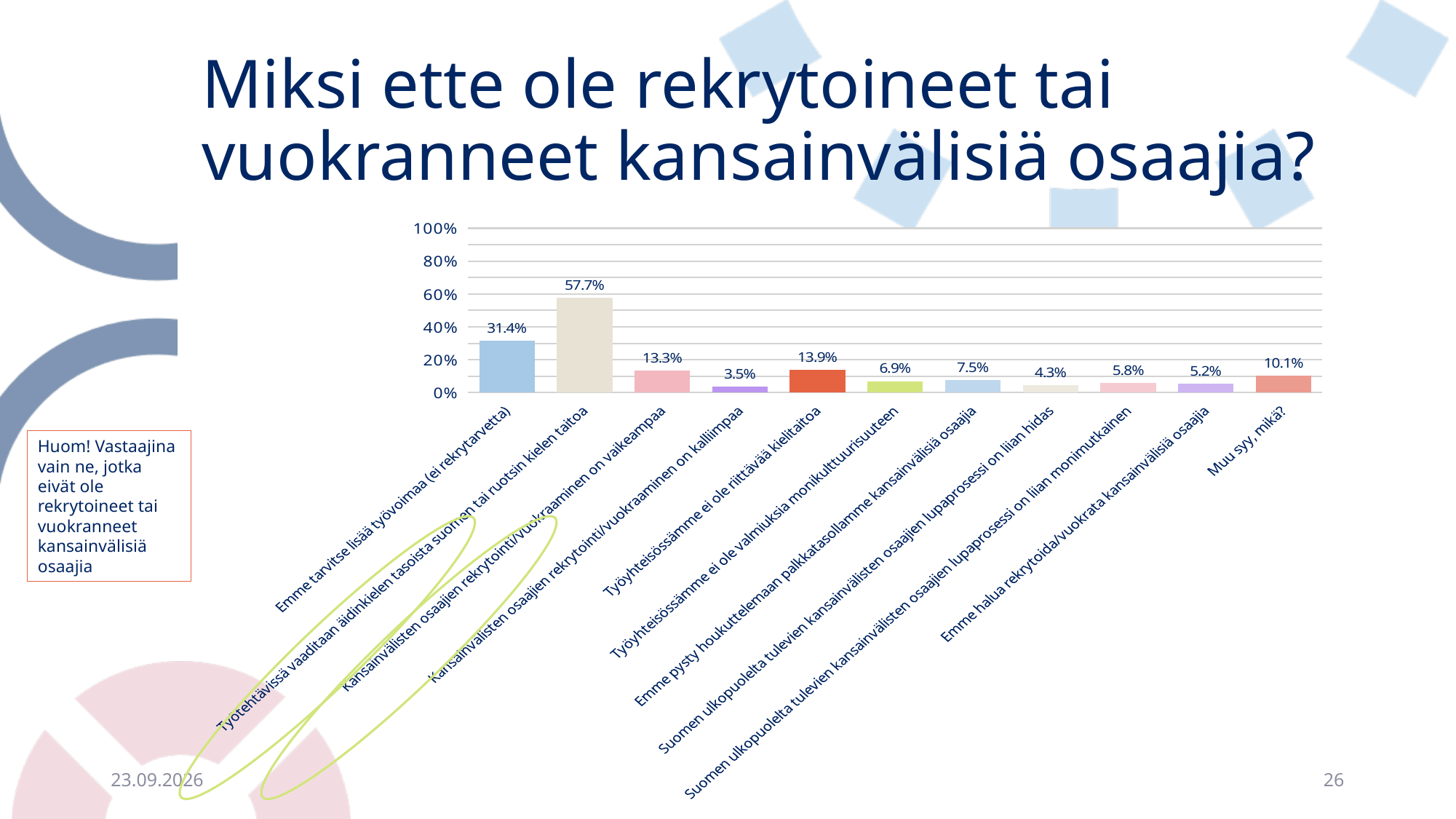
What kind of chart is shown on the slide? bar chart Is the value for "Emme tarvitse lisää työvoimaa (ei rekrytarvetta)" greater or less than 40%? less What is the value for "Muu syy, mikä?"? 10.1% Which is larger: the value for "Suomen ulkopuolelta tulevien kansainvälisten osaajien lupaprosessi on liian hidas" or for "Suomen ulkopuolelta tulevien kansainvälisten osaajien lupaprosessi on liian monimutkainen"? Suomen ulkopuolelta tulevien kansainvälisten osaajien lupaprosessi on liian monimutkainen What is the value for "Emme tarvitse lisää työvoimaa (ei rekrytarvetta)"? 31.4% Which category has the lowest value? Kansainvälisten osaajien rekrytointi/vuokraaminen on kalliimpaa How many categories (bars) does the chart show? 11 What is the value for "Työtehtävissä vaaditaan äidinkielen tasoista suomen tai ruotsin kielen taitoa"? 57.7% What is the title of the slide containing the chart? Miksi ette ole rekrytoineet tai vuokranneet kansainvälisiä osaajia? What is the value for "Työyhteisössämme ei ole riittävää kielitaitoa"? 13.9% Which category has the highest value? Työtehtävissä vaaditaan äidinkielen tasoista suomen tai ruotsin kielen taitoa What is the difference between the values for "Työtehtävissä vaaditaan äidinkielen tasoista suomen tai ruotsin kielen taitoa" and "Emme tarvitse lisää työvoimaa (ei rekrytarvetta)"? 26.3%